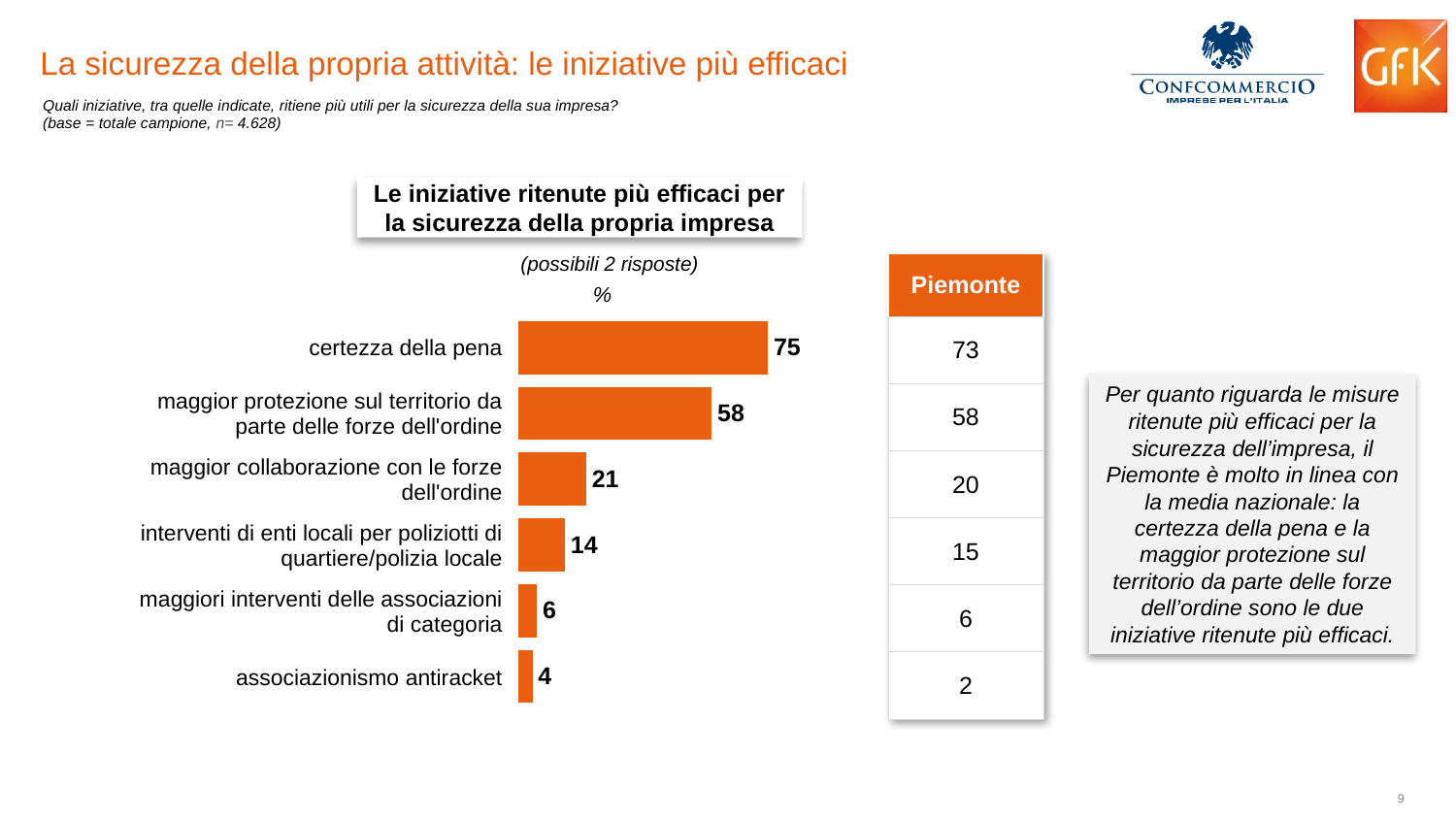
Which category has the highest value in the bar chart? certezza della pena What is the value for "associazionismo antiracket" in the bar chart? 4 How many categories are shown in the bar chart? 6 What is the value for "maggior protezione sul territorio da parte delle forze dell'ordine" in the bar chart? 58 What is the value for "certezza della pena" in the bar chart? 75 What kind of chart is shown on the slide? bar chart What is the title of the chart? Le iniziative ritenute più efficaci per la sicurezza della propria impresa What colour are the bars in the chart? orange What is the value for "interventi di enti locali per poliziotti di quartiere/polizia locale" in the bar chart? 14 What is the difference between the values for "certezza della pena" and "maggior protezione sul territorio da parte delle forze dell'ordine" in the bar chart? 17 Which category has the lowest value in the bar chart? associazionismo antiracket Which has a larger value in the bar chart: "maggior collaborazione con le forze dell'ordine" or "maggiori interventi delle associazioni di categoria"? maggior collaborazione con le forze dell'ordine